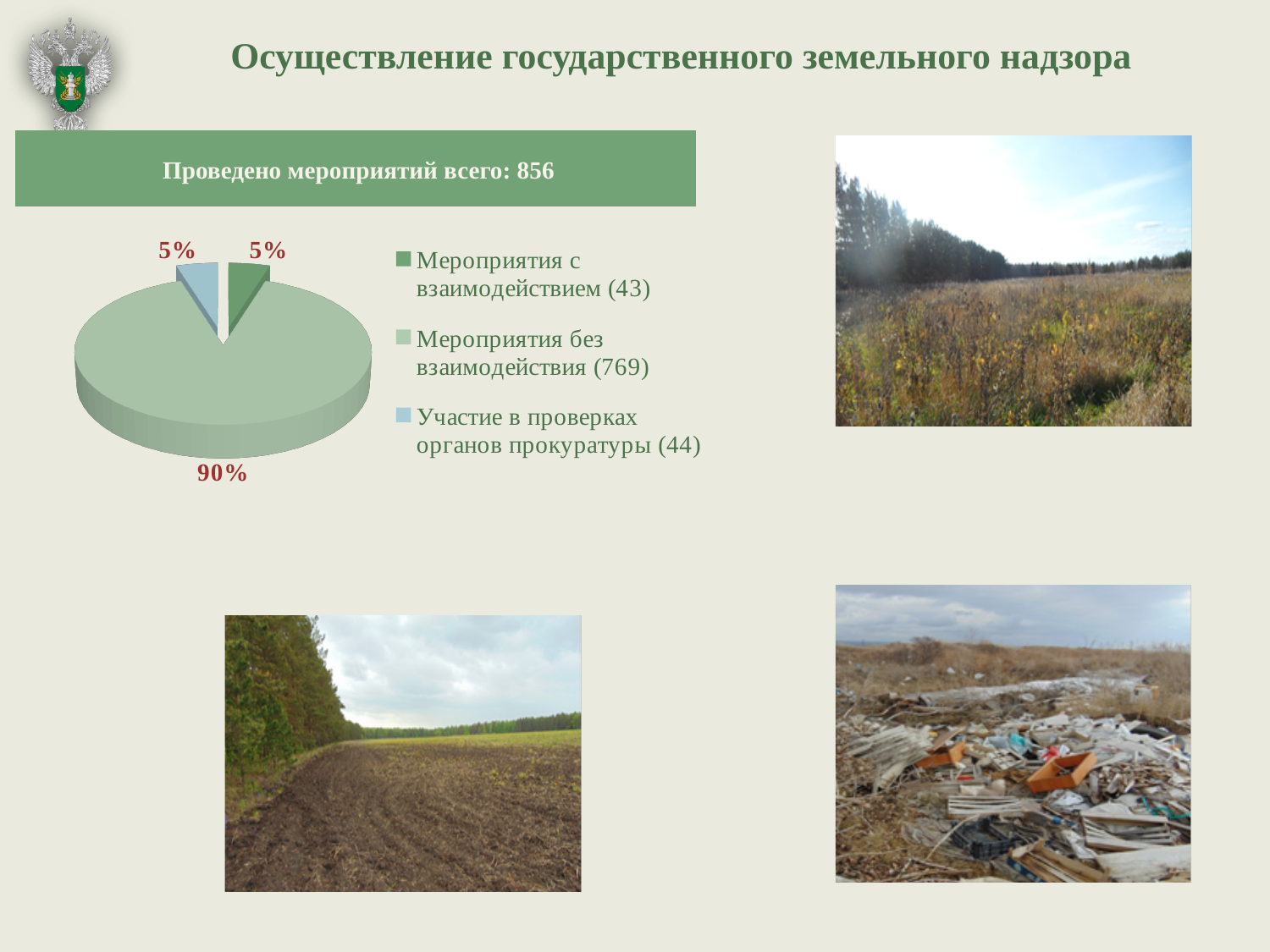
Which is larger: the share for "Мероприятия без взаимодействия" or the share for "Участие в проверках органов прокуратуры"? Мероприятия без взаимодействия What total number of events is stated in the header above the pie chart? 856 What kind of chart is shown on the slide? pie chart What share of the pie does "Участие в проверках органов прокуратуры" take? 5% Which category has the largest slice in the pie chart? Мероприятия без взаимодействия What share of the pie does "Мероприятия без взаимодействия" take? 90% How many slices does the pie chart have? 3 What is the difference in percentage points between the largest slice (90%) and the "Мероприятия с взаимодействием" slice (5%)? 85% How many entries does the legend of the pie chart list? 3 What share of the pie does "Мероприятия с взаимодействием" take? 5% What number is shown in parentheses in the legend for "Мероприятия без взаимодействия"? 769